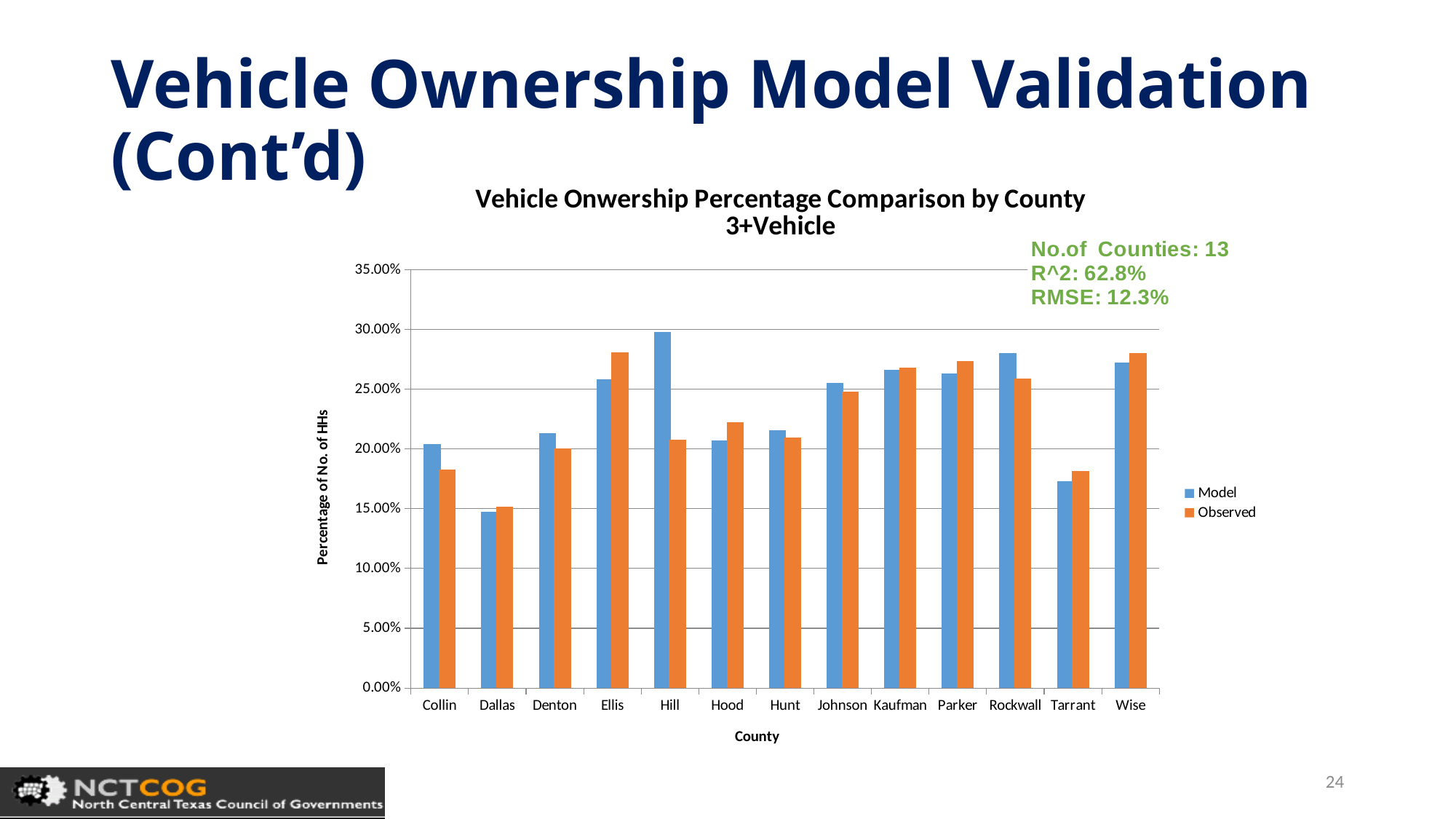
How many series does the chart's legend list? 2 Is the Model value for Hill greater or less than 25.00%? greater Is the Observed value for Hood greater or less than 20.00%? greater How many counties are shown on the x axis of the chart? 13 Is the Model value for Tarrant greater or less than 20.00%? less For Hill, which is larger: the Model value or the Observed value? Model What is the label of the chart's y axis? Percentage of No. of HHs Which county has the lowest Observed value? Dallas For Ellis, which is larger: the Model value or the Observed value? Observed Which county has the highest Model value? Hill Which county has the lowest Model value? Dallas What kind of chart is shown on the slide? Bar chart